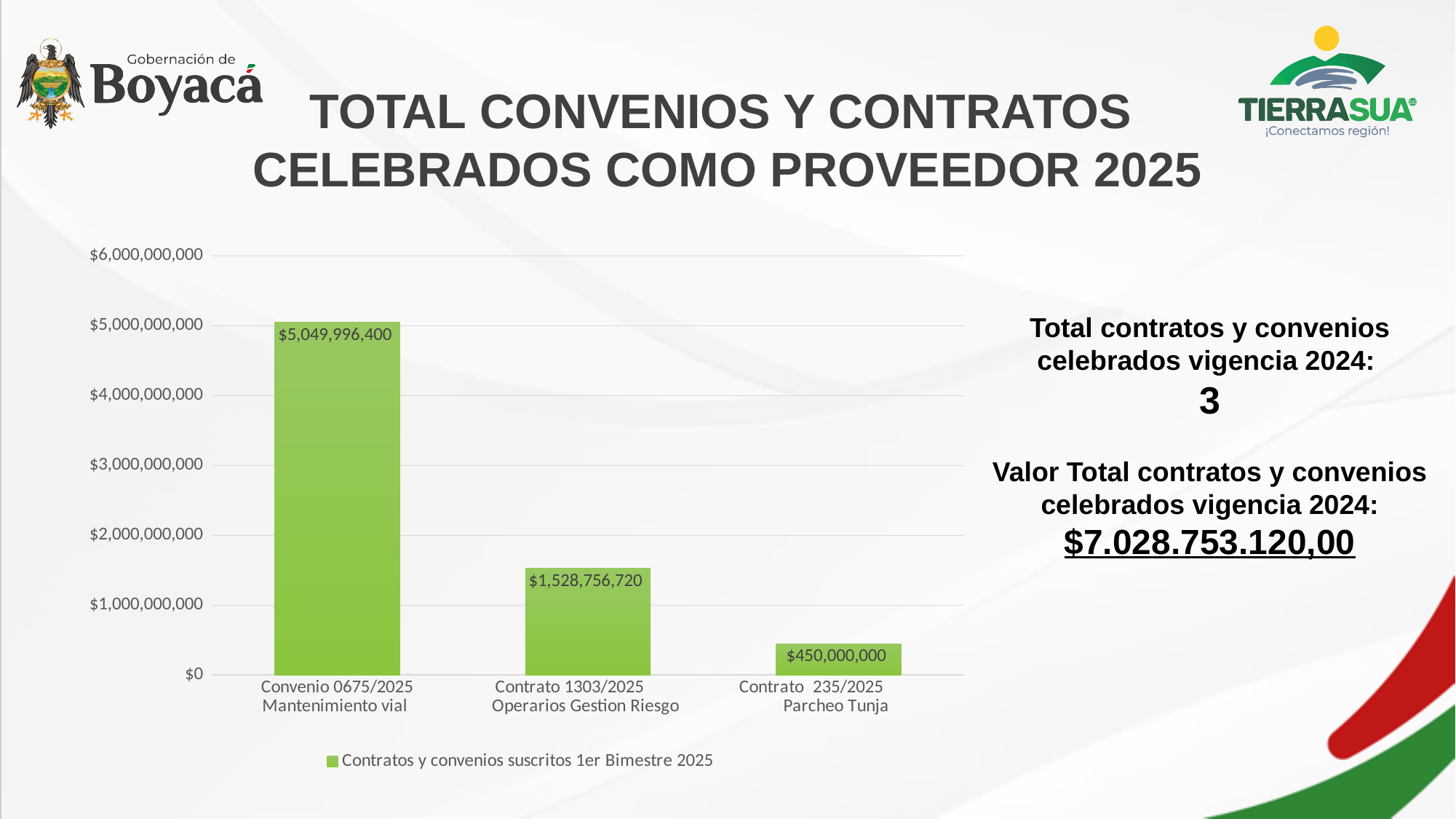
What is the legend entry of the chart? Contratos y convenios suscritos 1er Bimestre 2025 Which is larger, the value for Contrato 1303/2025 Operarios Gestion Riesgo or the value for Contrato 235/2025 Parcheo Tunja? Contrato 1303/2025 Operarios Gestion Riesgo Is the value for Convenio 0675/2025 Mantenimiento vial greater or less than $5,000,000,000? greater What kind of chart is shown on the slide? bar chart What is the value for Convenio 0675/2025 Mantenimiento vial? $5,049,996,400 What is the value for Contrato 235/2025 Parcheo Tunja? $450,000,000 What is the value for Contrato 1303/2025 Operarios Gestion Riesgo? $1,528,756,720 Which category has the highest value? Convenio 0675/2025 Mantenimiento vial What is the difference between the values for Contrato 1303/2025 Operarios Gestion Riesgo and Contrato 235/2025 Parcheo Tunja? $1,078,756,720 How many categories are shown in the chart? 3 Which category has the lowest value? Contrato 235/2025 Parcheo Tunja What is the difference between the values for Convenio 0675/2025 Mantenimiento vial and Contrato 1303/2025 Operarios Gestion Riesgo? $3,521,239,680